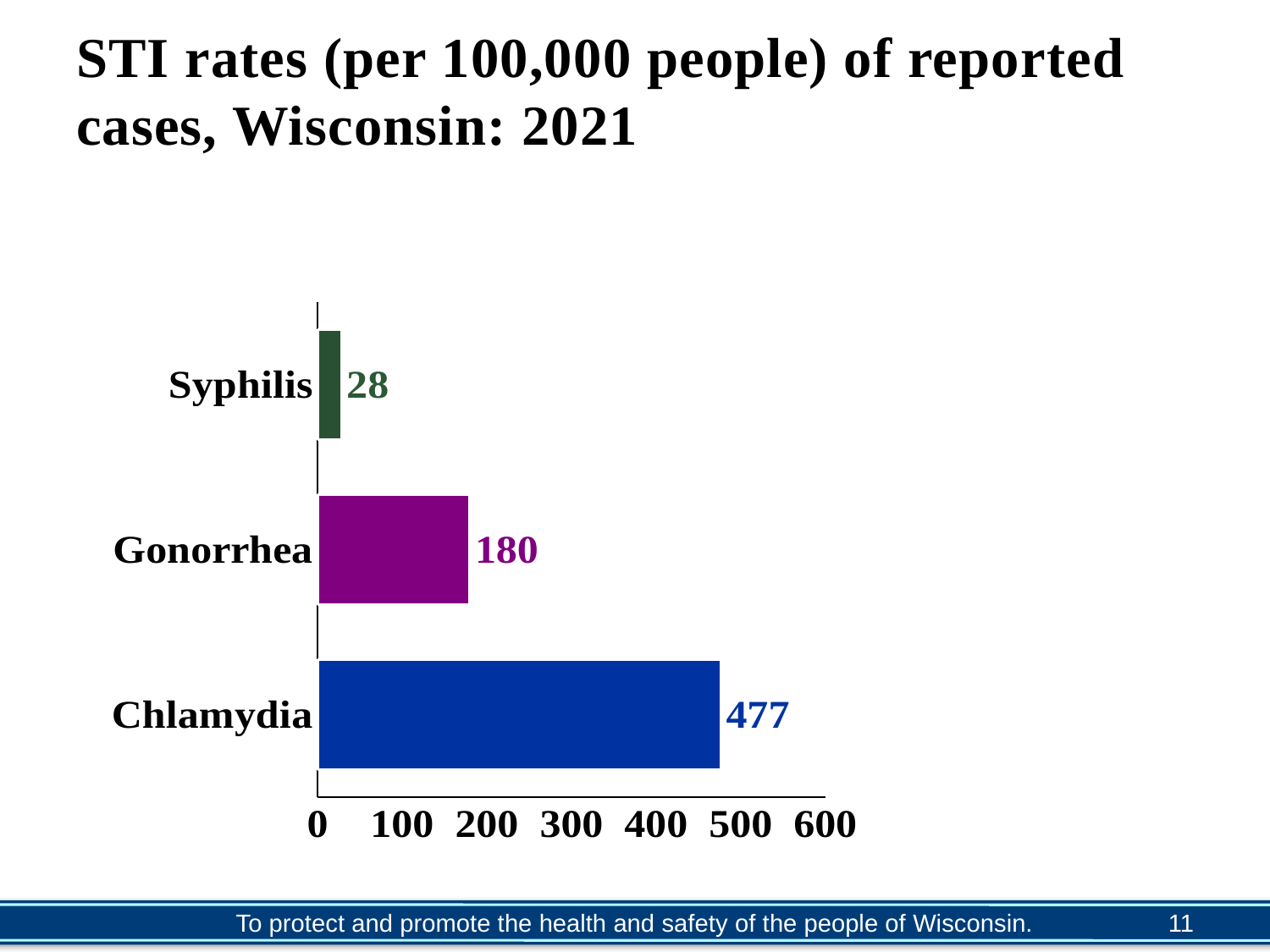
What is the STI rate per 100,000 people for Gonorrhea? 180 Which STI has the highest reported rate? Chlamydia What is the difference between the Chlamydia rate and the Gonorrhea rate? 297 What is the difference between the Gonorrhea rate and the Syphilis rate? 152 Is the value for Gonorrhea greater or less than 200? less Which has a higher rate, Gonorrhea or Syphilis? Gonorrhea What type of chart is shown on the slide? bar chart What is the STI rate per 100,000 people for Chlamydia? 477 Which STI has the lowest reported rate? Syphilis How many STI categories are shown in the chart? 3 What is the STI rate per 100,000 people for Syphilis? 28 What colour is the bar for Chlamydia? blue